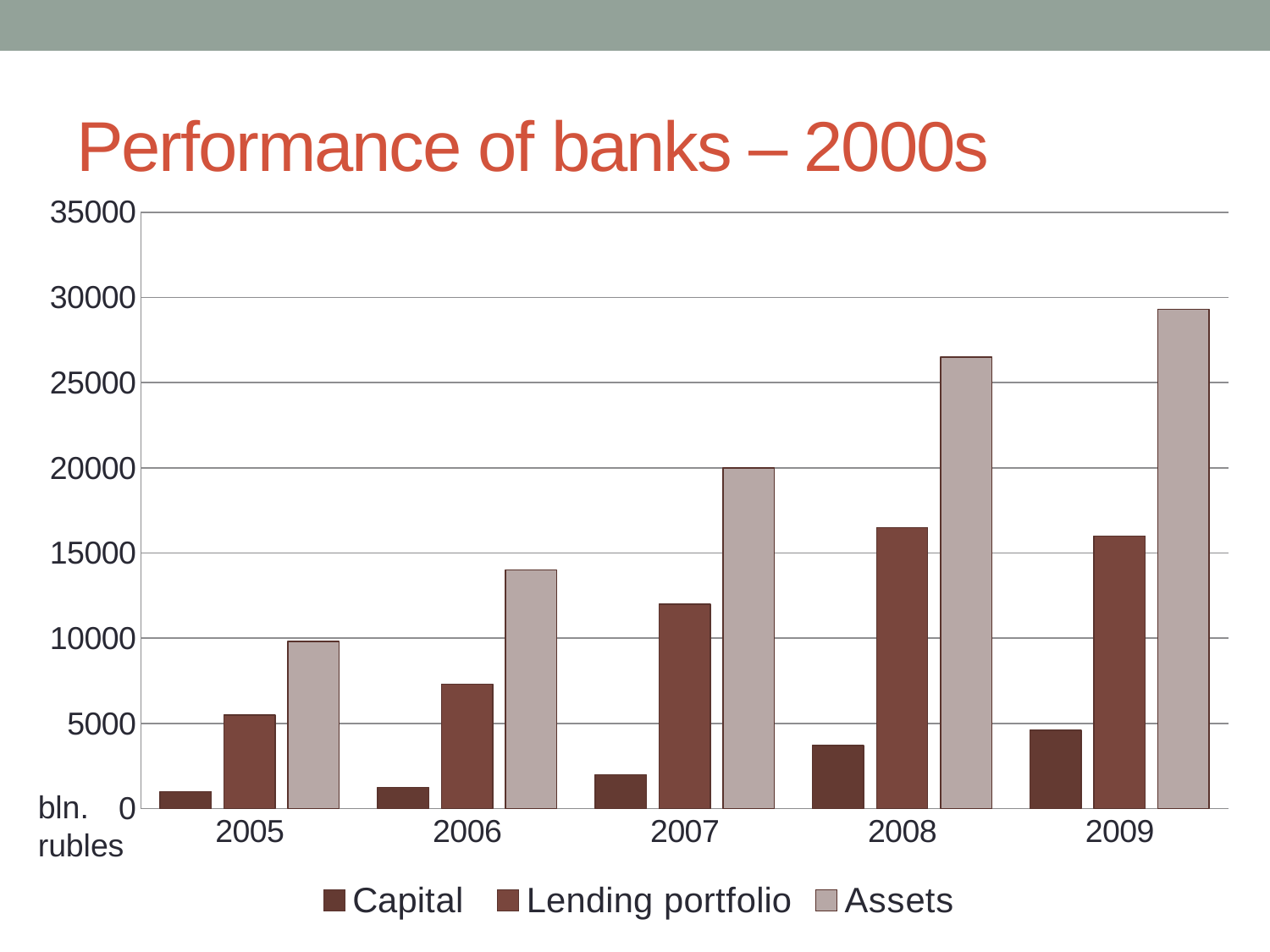
Is the Assets value for 2009 greater or less than 25000? greater How many years are shown on the x axis? 5 Which year has the lowest Capital bar? 2005 Do the Assets values rise or fall from 2005 to 2009? rise Which is larger: Assets in 2007 or Lending portfolio in 2008? Assets in 2007 Is the Capital value for 2009 greater or less than 5000? less What unit is given for the y axis? bln. rubles Which series has the tallest bar in 2009? Assets How many series does the legend list? 3 Is the Lending portfolio value for 2006 greater or less than 5000? greater What kind of chart is shown on the slide? bar chart